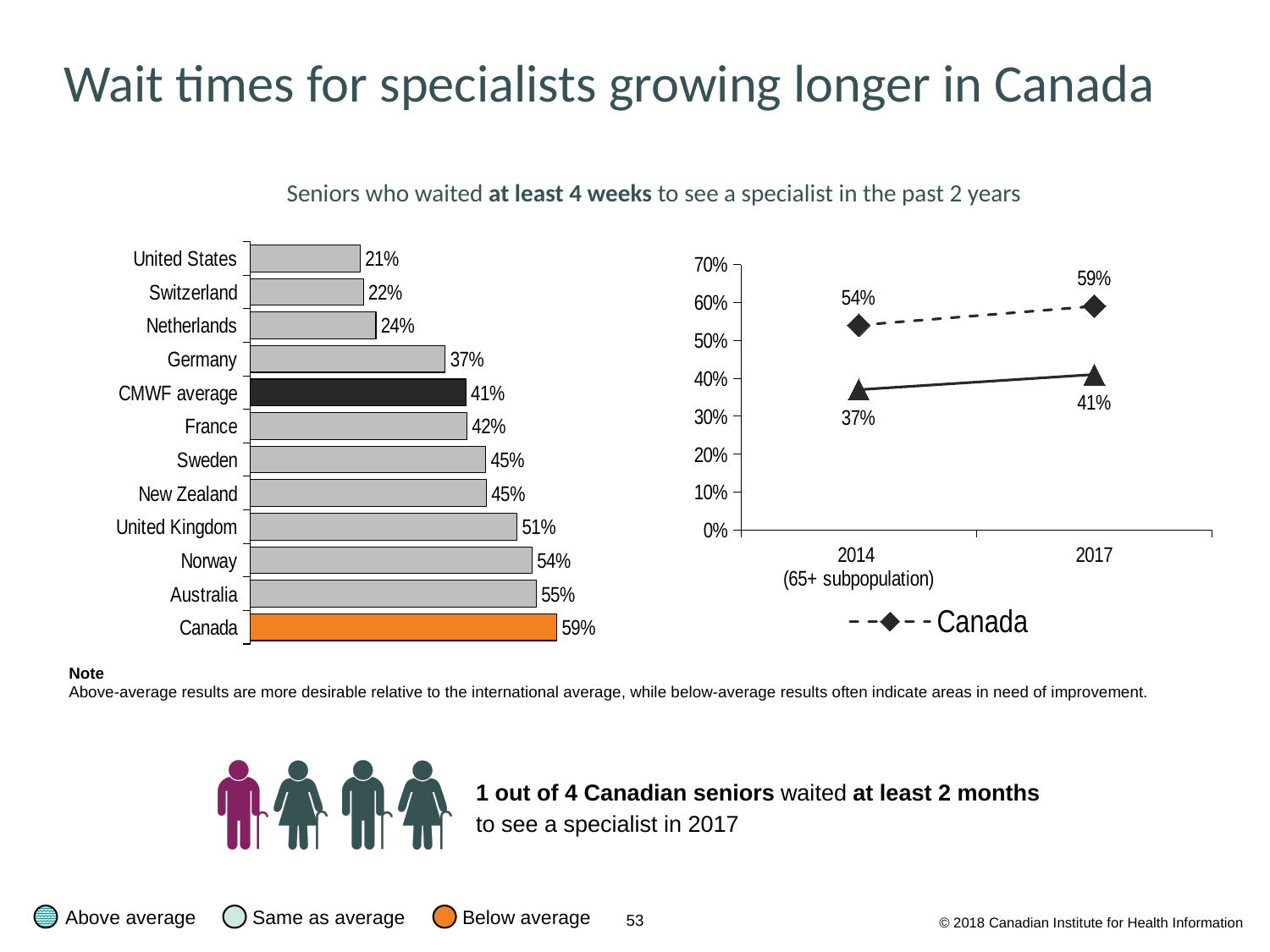
In the bar chart on the left, what percentage of seniors in Canada waited at least 4 weeks to see a specialist? 59% In the line chart on the right, does Canada's value rise or fall from 2014 to 2017? Rise In the bar chart on the left, which country has the highest percentage? Canada In the line chart on the right, what was Canada's value in 2014? 54% In the bar chart on the left, which country has the lowest percentage? United States In the bar chart on the left, what colour is the bar for Canada? Orange In the bar chart on the left, what is the difference between Canada's value and the CMWF average? 18% In the line chart on the right, what was Canada's value in 2017? 59% What type of chart is the chart on the left of the slide? Bar chart How many categories (bars) are shown in the bar chart on the left? 12 In the bar chart on the left, what is the value for the CMWF average? 41% In the bar chart on the left, which has a higher value, Germany or the United Kingdom? United Kingdom